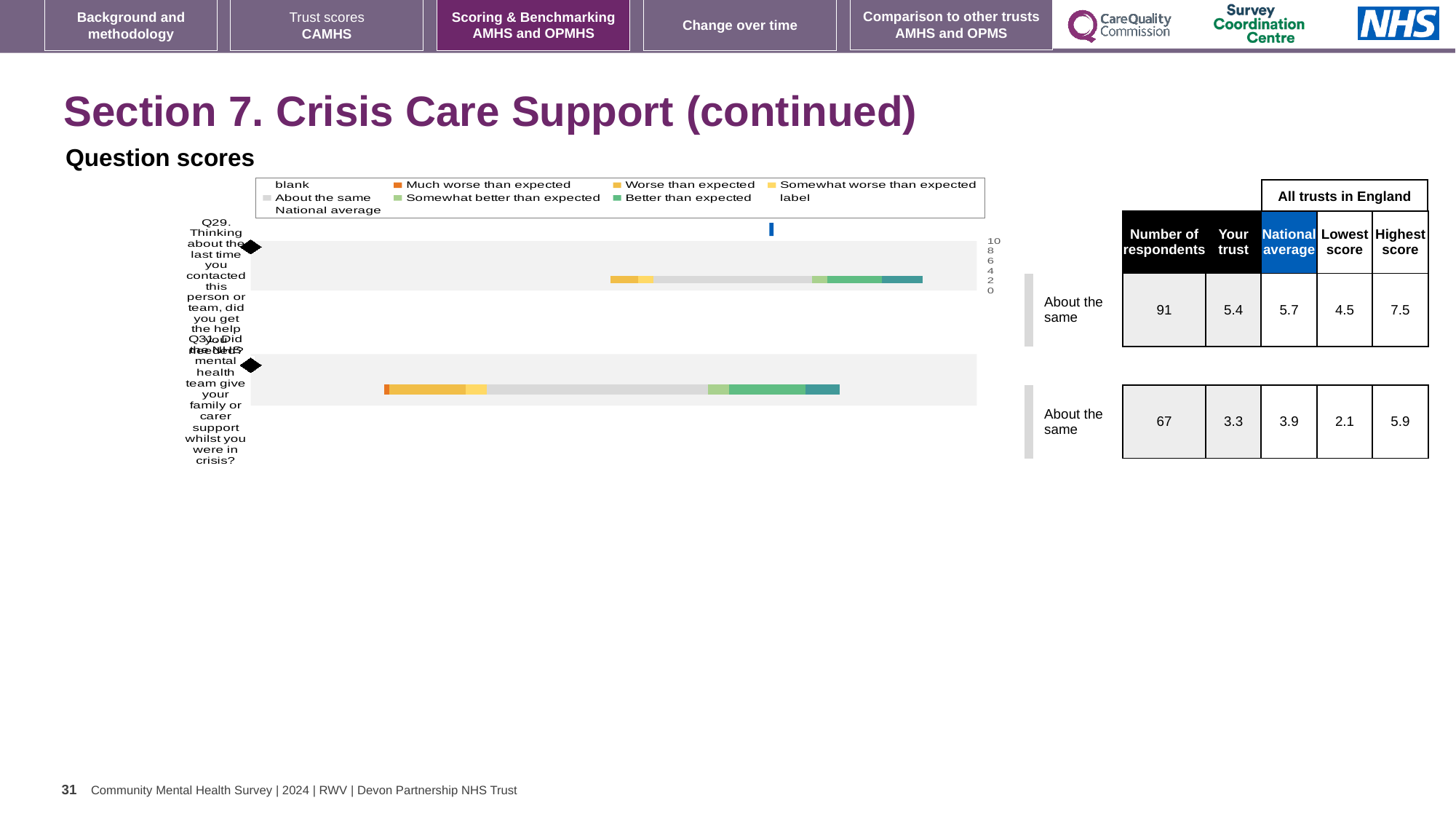
How many questions (categories) are plotted in the question scores chart? 2 Which question has the larger number of respondents, Q29 or Q31? Q29 In the table beside the chart, what is the 'Your trust' score for Q29? 5.4 For Q29, which is larger: the 'Your trust' score or the national average? national average What colour does the legend use for 'Much worse than expected'? orange In the table beside the chart, what is the highest score for Q29? 7.5 What benchmark category is shown next to the chart for Q31? About the same In the table beside the chart, how many respondents are listed for Q31? 67 What is the difference between the highest score and the lowest score for Q31? 3.8 Which legend entry in the question scores chart is shown in grey? About the same In the table beside the chart, what is the national average for Q31? 3.9 What kind of chart is used to show the question scores on this slide? bar chart